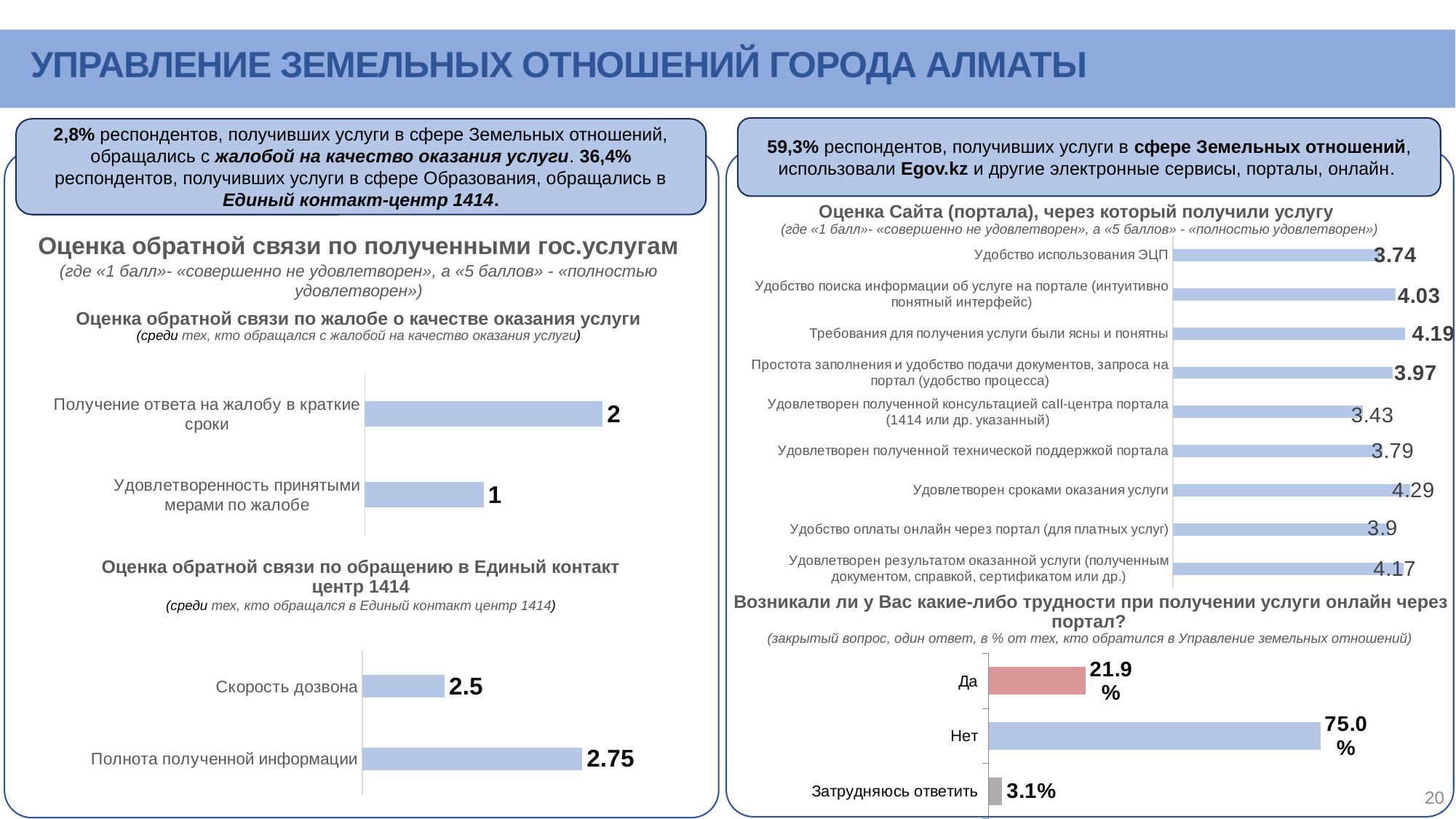
In the chart 'Оценка Сайта (портала), через который получили услугу', which category has the highest value? Удовлетворен сроками оказания услуги In the chart 'Оценка Сайта (портала), через который получили услугу', which is larger: 'Требования для получения услуги были ясны и понятны' or 'Удобство оплаты онлайн через портал (для платных услуг)'? Требования для получения услуги были ясны и понятны In the chart 'Оценка Сайта (портала), через который получили услугу', which category has the lowest value? Удовлетворен полученной консультацией call-центра портала (1414 или др. указанный) What type of chart is 'Возникали ли у Вас какие-либо трудности при получении услуги онлайн через портал?'? Bar chart In the chart 'Возникали ли у Вас какие-либо трудности при получении услуги онлайн через портал?', what is the value for 'Нет'? 75.0% In the chart 'Возникали ли у Вас какие-либо трудности при получении услуги онлайн через портал?', what is the difference between 'Нет' and 'Да'? 53.1% In the chart 'Оценка обратной связи по обращению в Единый контакт центр 1414', what is the value for 'Скорость дозвона'? 2.5 In the chart 'Оценка обратной связи по обращению в Единый контакт центр 1414', what is the difference between 'Полнота полученной информации' and 'Скорость дозвона'? 0.25 In the chart 'Оценка обратной связи по жалобе о качестве оказания услуги', what is the value for 'Удовлетворенность принятыми мерами по жалобе'? 1 In the chart 'Оценка обратной связи по жалобе о качестве оказания услуги', what is the value for 'Получение ответа на жалобу в краткие сроки'? 2 In the chart 'Оценка Сайта (портала), через который получили услугу', what is the value for 'Удобство использования ЭЦП'? 3.74 In the chart 'Оценка Сайта (портала), через который получили услугу', how many categories are plotted? 9